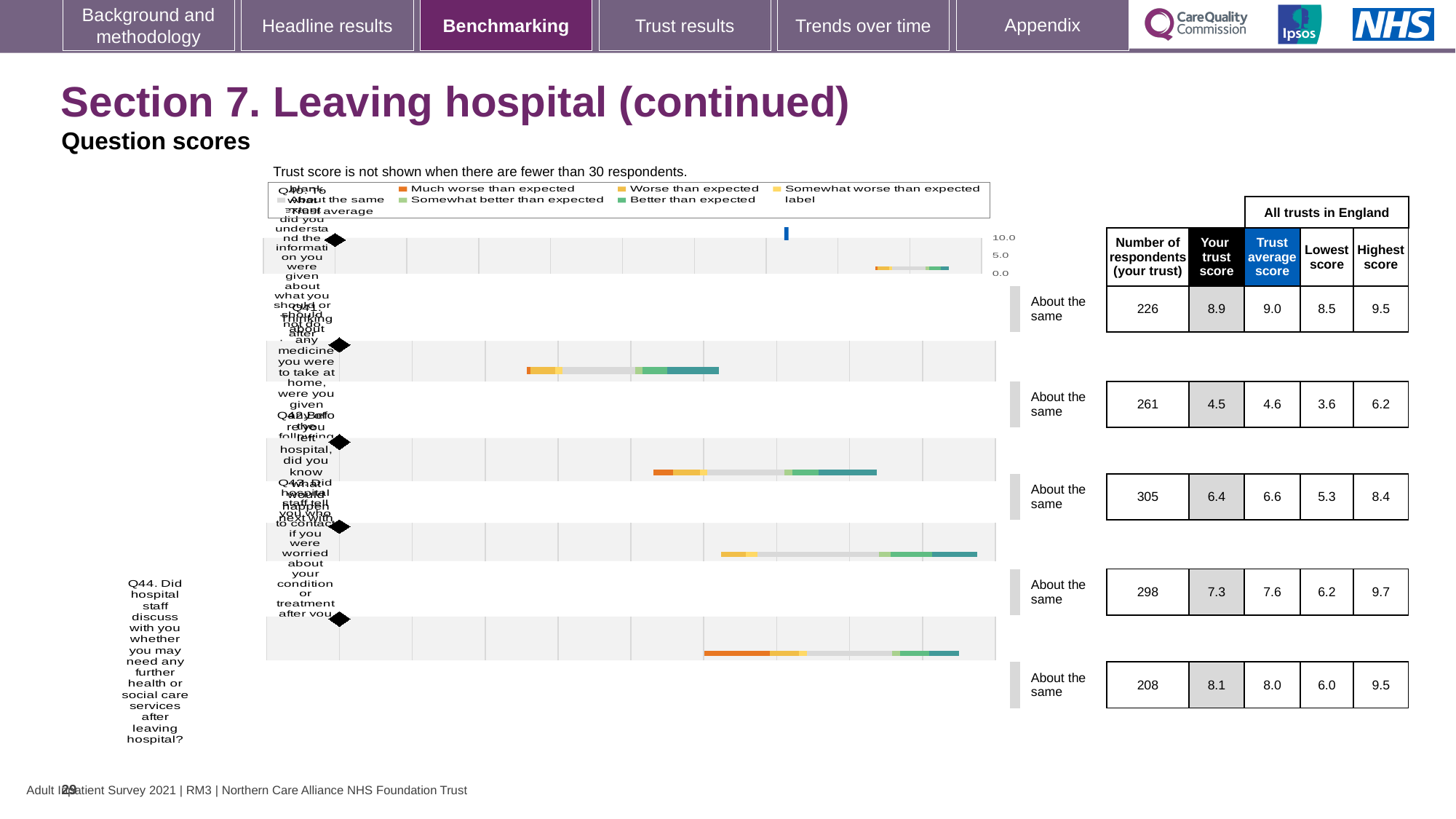
What is 'Your trust score' for Q44 (the last row)? 8.1 What is the 'Trust average score' for Q44 (the last row)? 8.0 What is the 'Lowest score' across all trusts in England for Q44 (the last row)? 6.0 How many question rows are plotted on the chart? 5 For Q44 (the last row), is 'Your trust score' higher or lower than the 'Trust average score'? higher What is the difference between the highest score and the lowest score for Q44 (the last row)? 3.5 What benchmark category is shown next to Q44 (the last row)? About the same How many respondents (your trust) are shown for the first question row? 226 What is the 'Highest score' across all trusts in England for Q44 (the last row)? 9.5 How many respondents (your trust) are shown for Q44 (the last row)? 208 Which question row has the lowest 'Your trust score'? The second row (4.5) What kind of chart is used to show the question scores? Bar chart